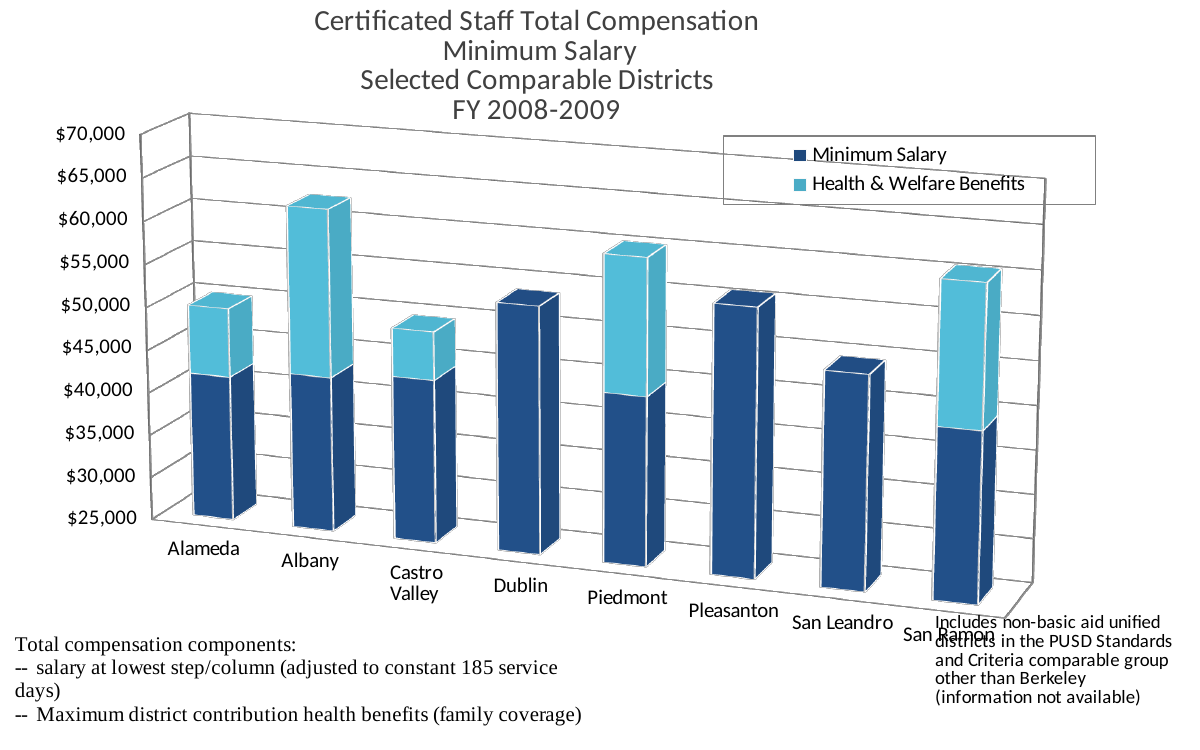
What kind of chart is shown on the slide? Stacked bar chart Which district has the lowest total compensation bar? San Leandro Which is larger, the total compensation for Albany or for Piedmont? Albany Which district has the highest total compensation bar? Albany How many series does the chart's legend list? 2 Which district has the larger Health & Welfare Benefits portion, Alameda or San Ramon? San Ramon Is the total compensation for Albany greater or less than $55,000? greater Which series in the legend is shown in light blue? Health & Welfare Benefits Is the total compensation for Piedmont greater or less than $50,000? greater How many districts are shown on the x axis of the chart? 8